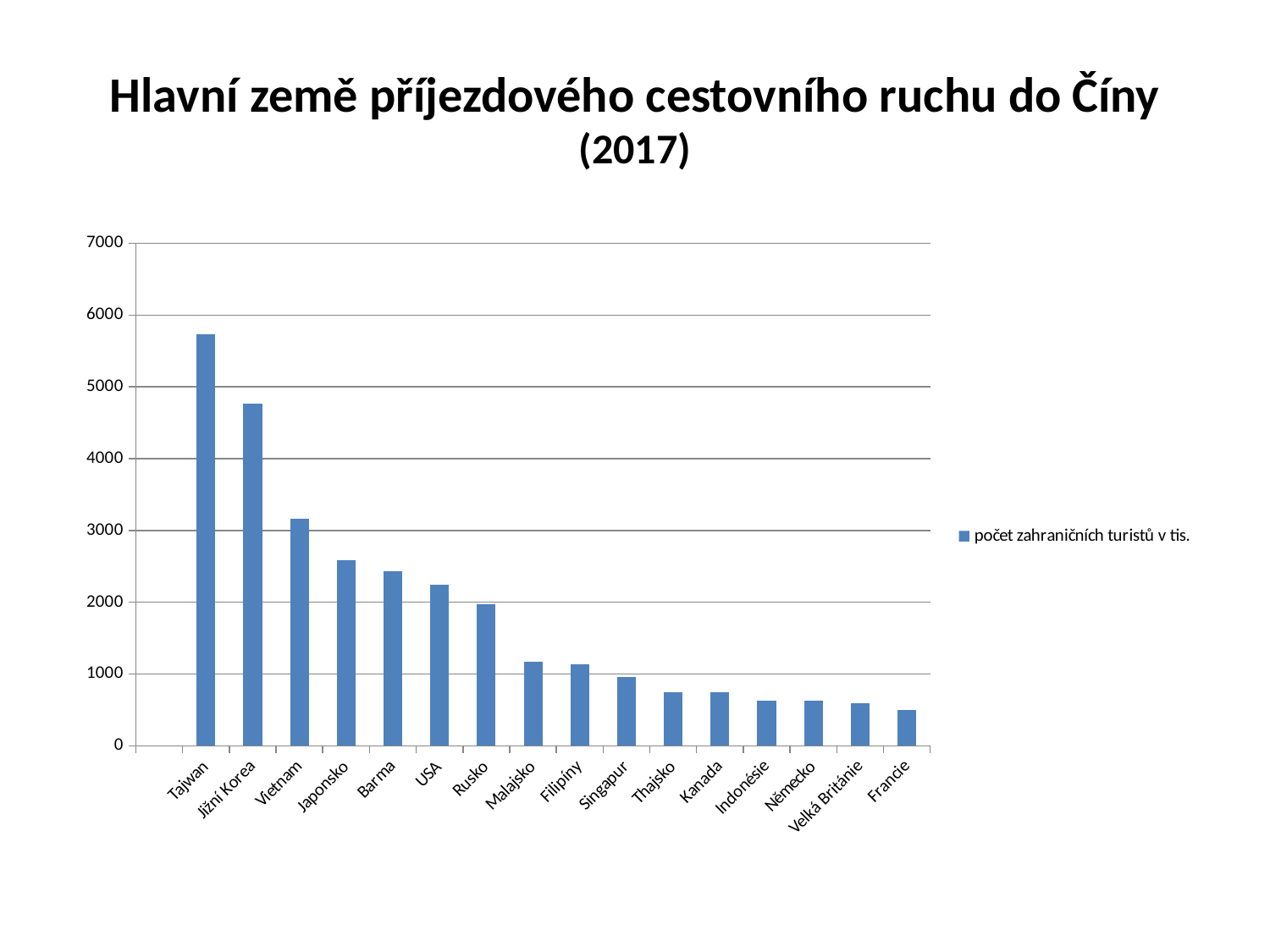
How many countries are shown on the x axis of the chart? 16 Is the value for Jižní Korea greater or less than 5000? less Which has a larger value, Vietnam or Japonsko? Vietnam Is the value for Vietnam greater or less than 3000? greater Which country has the highest number of foreign tourists in the chart? Tajwan Do the values rise or fall moving from left to right along the x axis? fall Which country has the lowest number of foreign tourists in the chart? Francie What kind of chart is shown on the slide? bar chart Is the value for Tajwan greater or less than 5000? greater What is the legend entry for the series in the chart? počet zahraničních turistů v tis. How many series does the legend list? 1